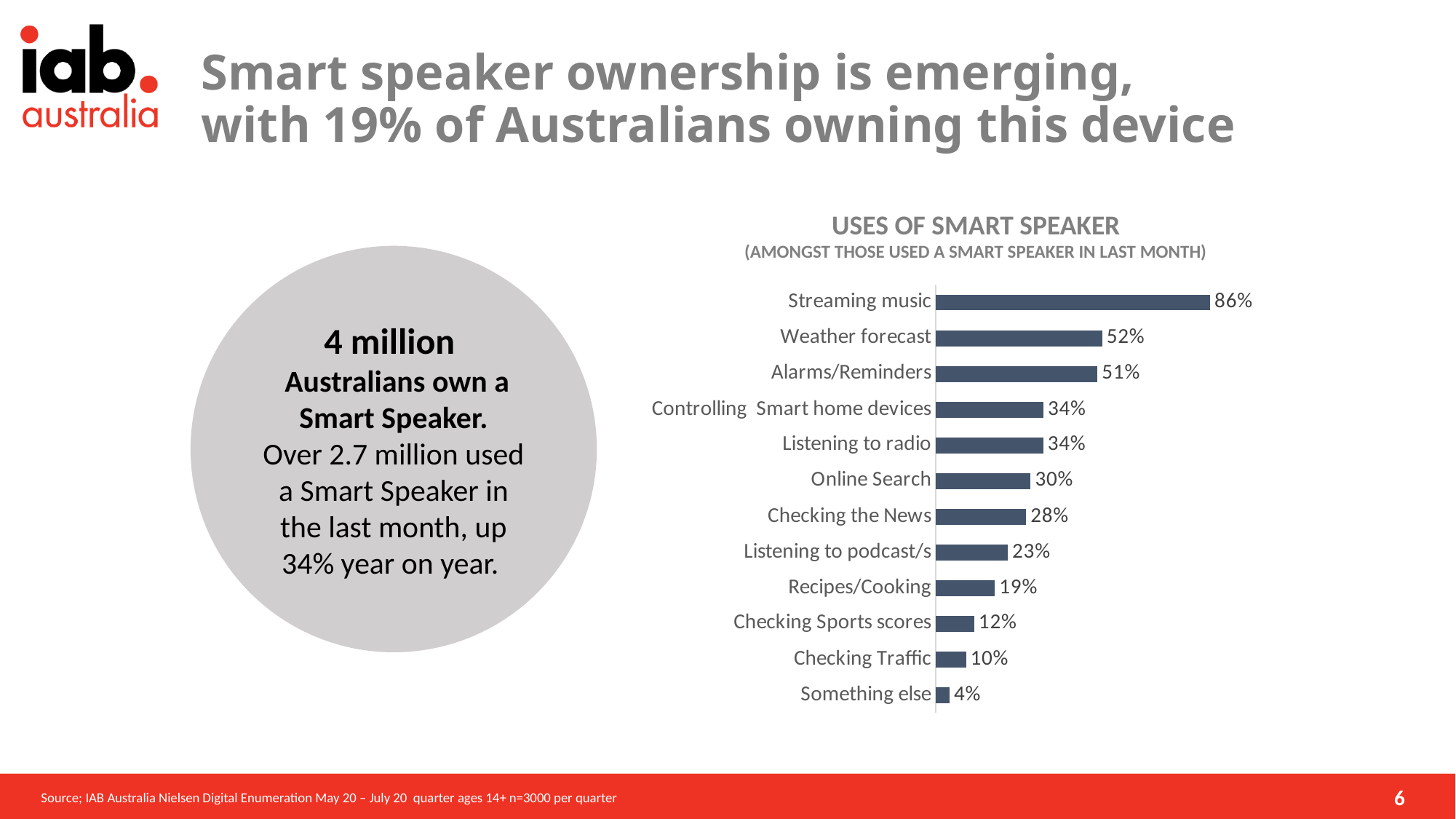
What is the difference between Listening to podcast/s and Checking Traffic? 13% Which use of smart speaker has the highest percentage? Streaming music What is the difference between the values for Streaming music and Weather forecast? 34% What is the value for Recipes/Cooking? 19% What percentage of smart speaker users use it for streaming music? 86% What is the title of the chart? USES OF SMART SPEAKER What type of chart is used to show the uses of smart speaker? Bar chart Which category has the lowest value in the chart? Something else Which is larger, Alarms/Reminders or Listening to radio? Alarms/Reminders How many categories are shown in the chart? 12 Which is larger, Online Search or Checking Sports scores? Online Search What is the value for Checking the News? 28%